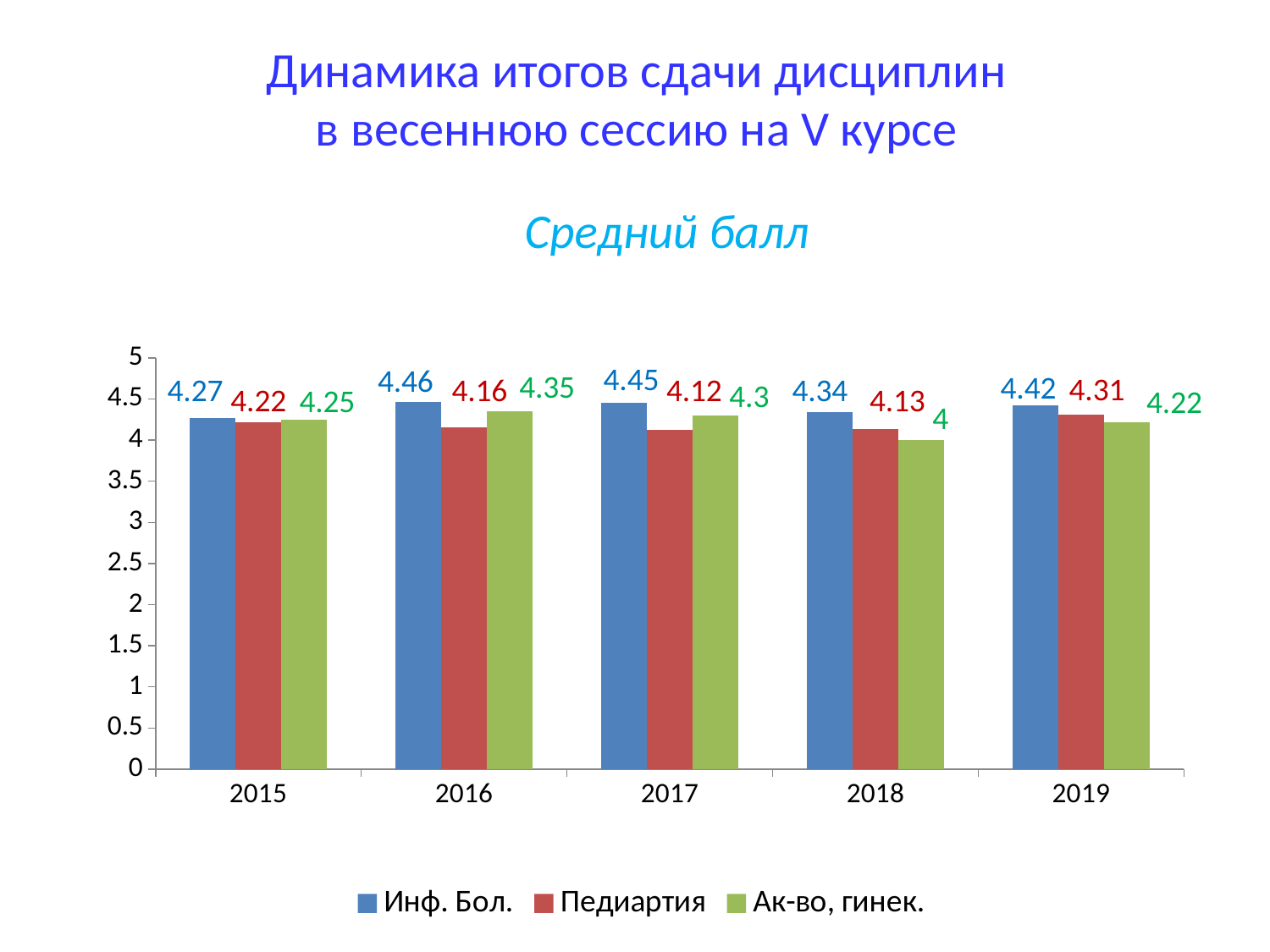
How many years are shown on the x axis? 5 In which year is the value for Педиартия the lowest? 2017 What is the value for Ак-во, гинек. in 2018? 4 What is the title of the chart? Средний балл Does the value for Ак-во, гинек. rise or fall from 2017 to 2018? Fall What is the value for Инф. Бол. in 2016? 4.46 In which year is the value for Инф. Бол. the highest? 2016 How many series does the legend list? 3 Which is larger in 2015: the value for Педиартия or the value for Ак-во, гинек.? Ак-во, гинек. What is the value for Педиартия in 2019? 4.31 What is the difference between the Инф. Бол. and Педиартия values in 2017? 0.33 What kind of chart is shown on the slide? Bar chart